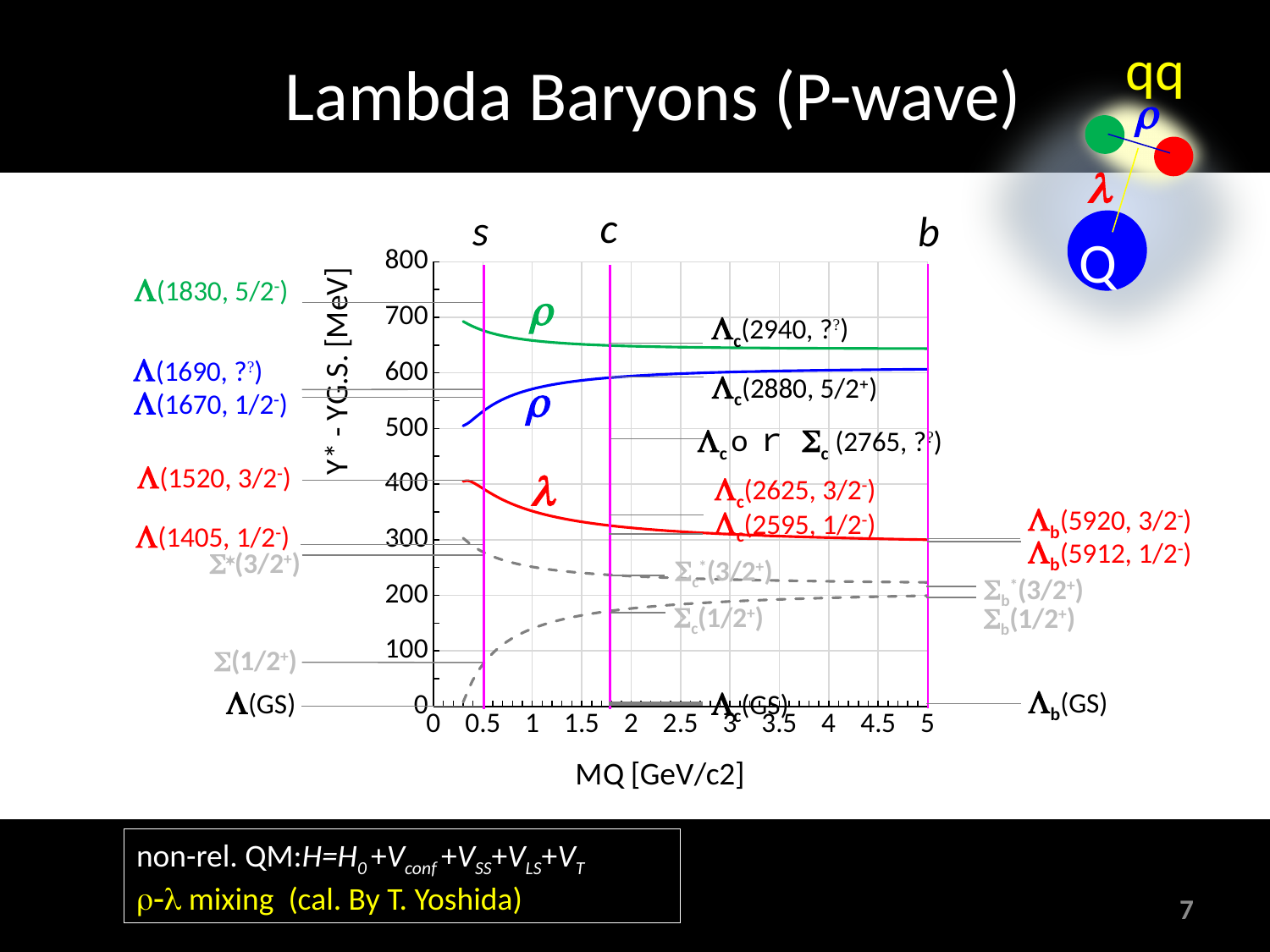
Does the green ρ curve rise or fall as MQ increases along the x axis? fall At the vertical line marked b, is the value of the red λ curve greater or less than 400? less Does the red λ curve rise or fall as MQ increases along the x axis? fall What kind of chart is shown on the slide? line chart What is the highest tick value shown on the y axis of the chart? 800 Does the blue ρ curve rise or fall as MQ increases along the x axis? rise What is the label of the y axis of the chart? Y* - YG.S. [MeV] At the vertical line marked c, which curve has the larger value, the green ρ curve or the blue ρ curve? green ρ curve What is the label of the x axis of the chart? MQ [GeV/c2] At the vertical line marked s, is the value of the red λ curve greater or less than 300? greater At the vertical line marked b, is the value of the green ρ curve greater or less than 600? greater How many vertical magenta lines (marked s, c, b) are drawn on the chart? 3